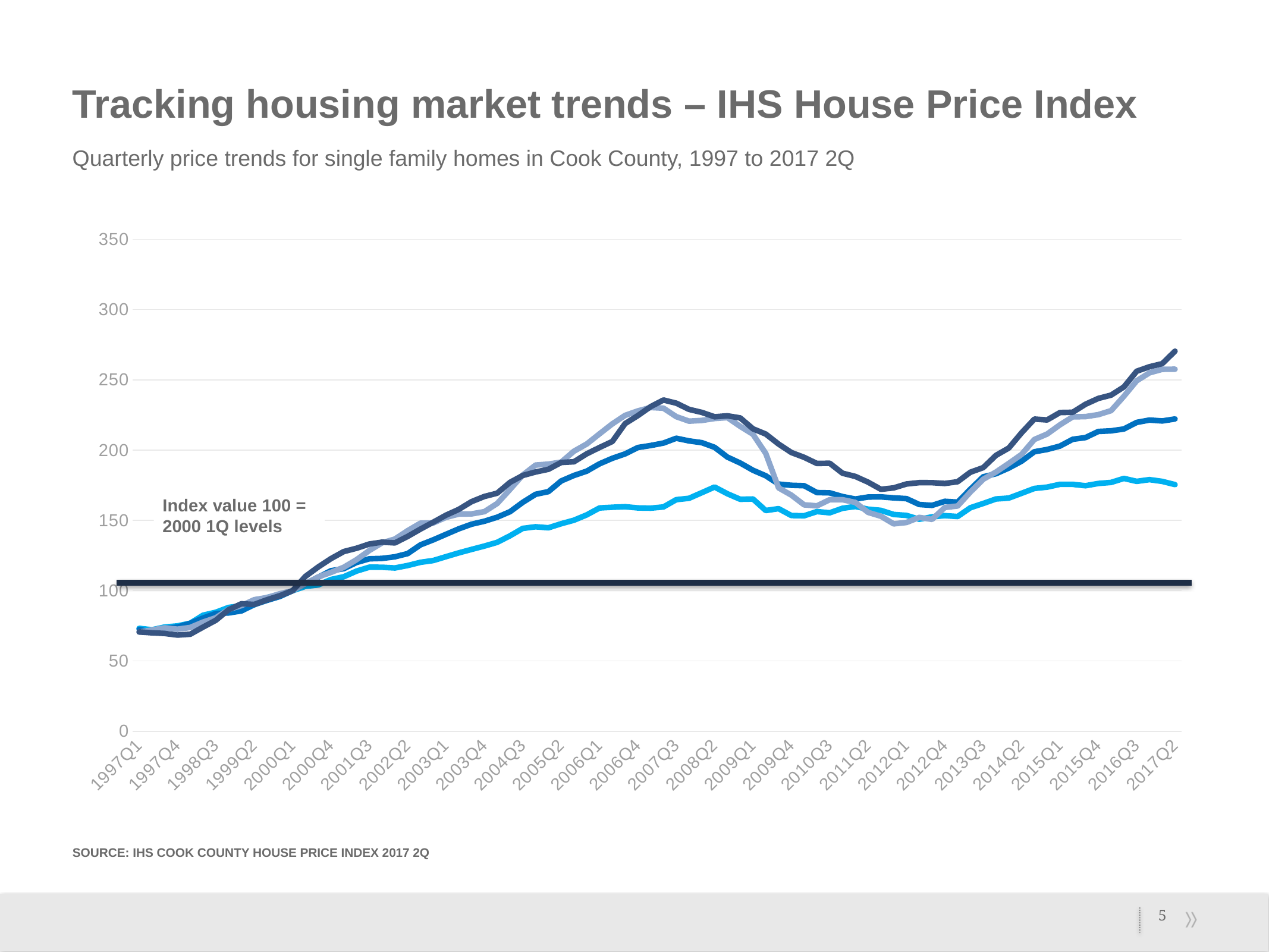
Is the value of the light blue line at 2017Q2 greater or less than 150? greater What kind of chart is shown on the slide? line chart Is the value of the dark navy line at 2017Q2 greater or less than 250? greater What is the title of the slide's chart? Tracking housing market trends – IHS House Price Index At 1997Q1, are the plotted lines greater or less than 100? less Do the lines generally rise or fall between 1997Q1 and 2007Q3? rise What is the highest value shown on the y axis? 350 According to the annotation on the chart, what does an index value of 100 represent? 2000 1Q levels Do the lines generally rise or fall between 2007Q3 and 2012Q1? fall Do the lines generally rise or fall between 2012Q4 and 2017Q2? rise